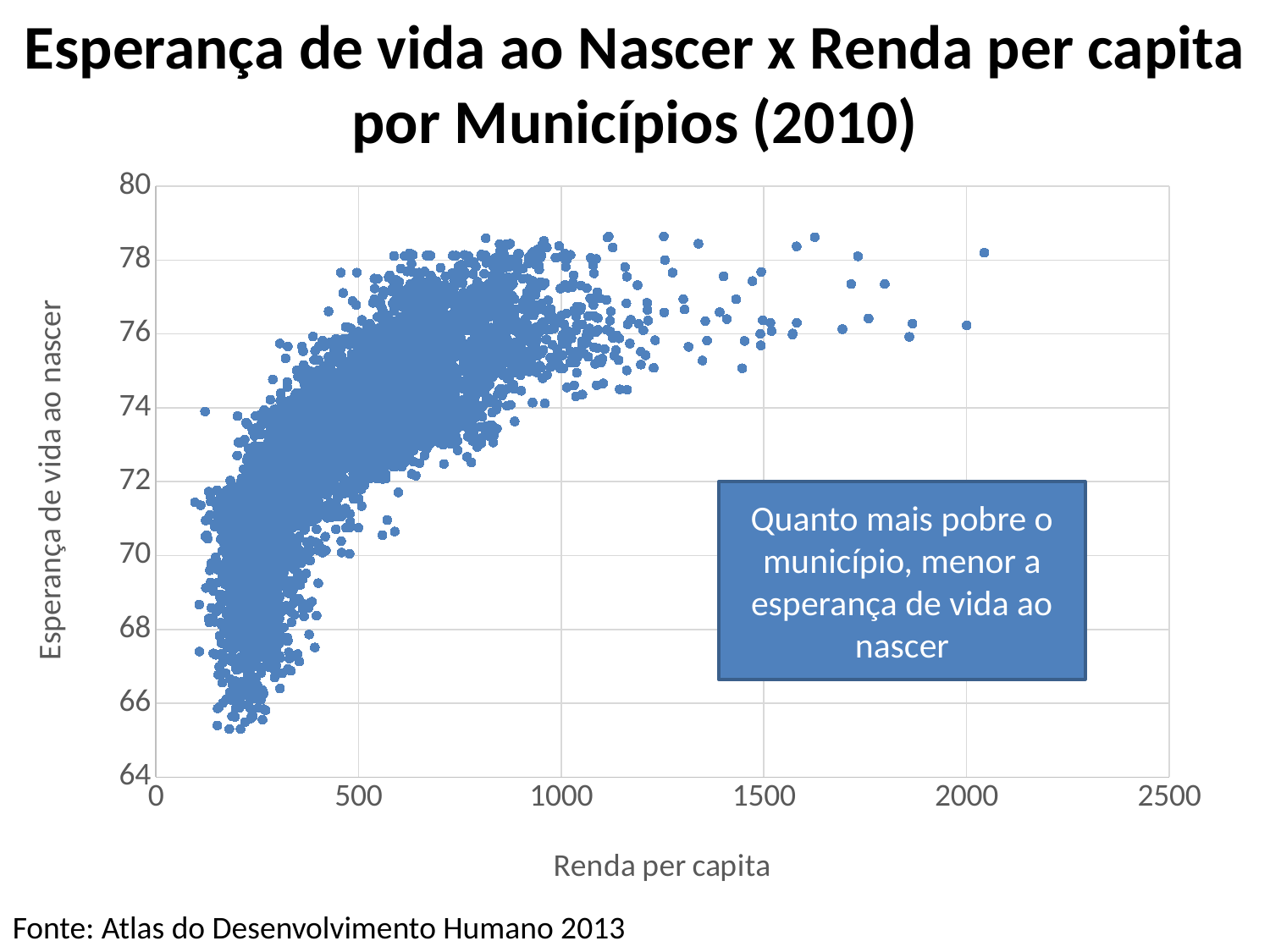
What is the label of the x axis? Renda per capita For municipalities with Renda per capita above 1500, are the plotted life expectancy values greater or less than 74? greater Are the lowest plotted life expectancy values (around Renda per capita of 200) greater or less than 66? less What kind of chart is shown on the slide? Scatter plot As Renda per capita increases along the x axis, does Esperança de vida ao nascer generally rise or fall? Rise Is any plotted point above 80 on the y axis? No What is the title of the chart? Esperança de vida ao Nascer x Renda per capita por Municípios (2010)